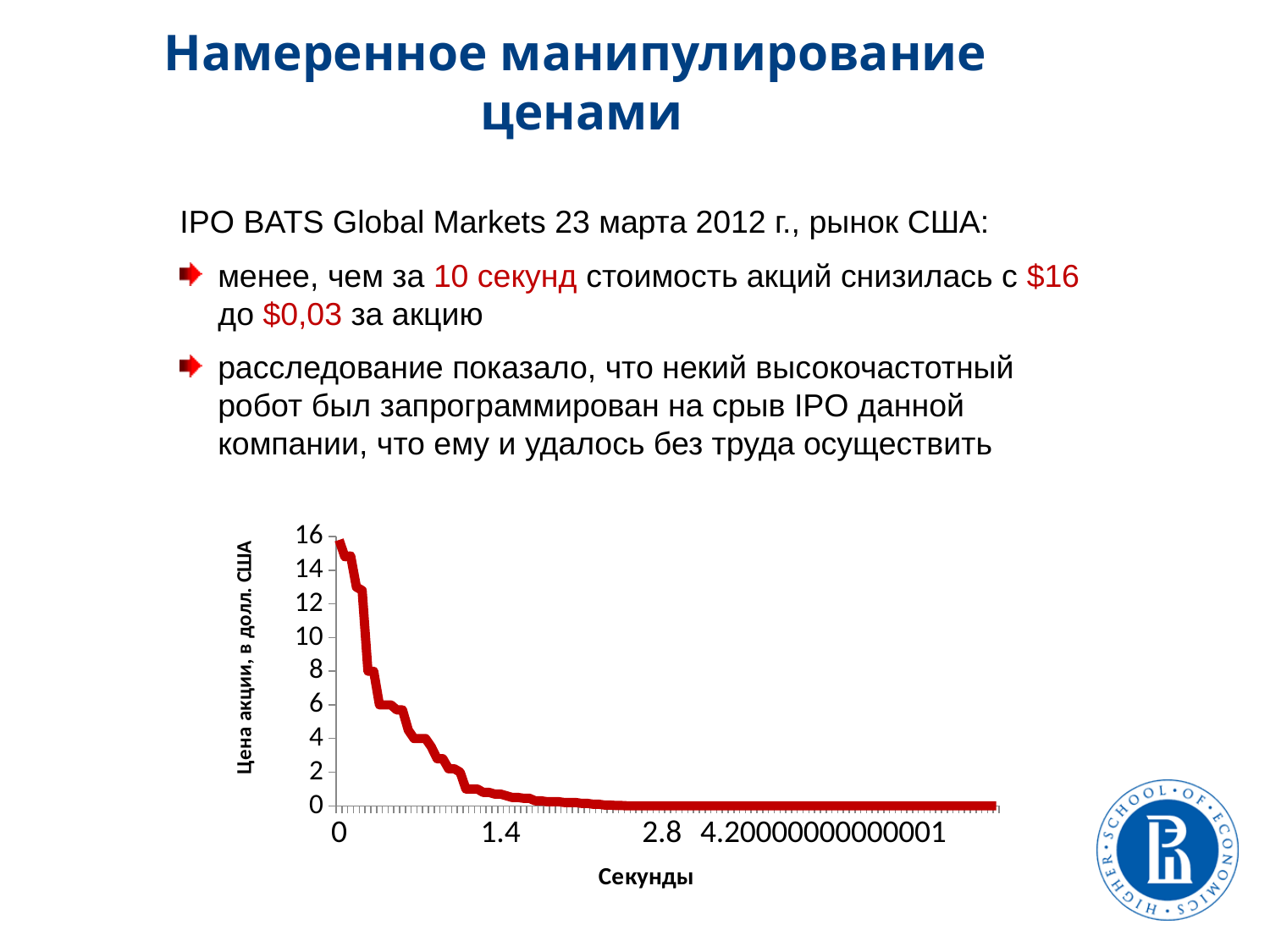
Is the value of the line at 2.8 seconds greater or less than 2? less Do the values on the chart rise or fall as the x axis (Секунды) increases? fall Is the value of the line at 1.4 seconds greater or less than 2? less What is the highest value shown on the vertical axis of the chart? 16 What kind of chart is shown on the slide? line chart What is the title of the vertical axis of the chart? Цена акции, в долл. США How many tick labels are printed on the horizontal axis of the chart? 4 What is the title of the horizontal axis of the chart? Секунды Is the value at the start of the line (at 0 seconds) greater or less than 14? greater